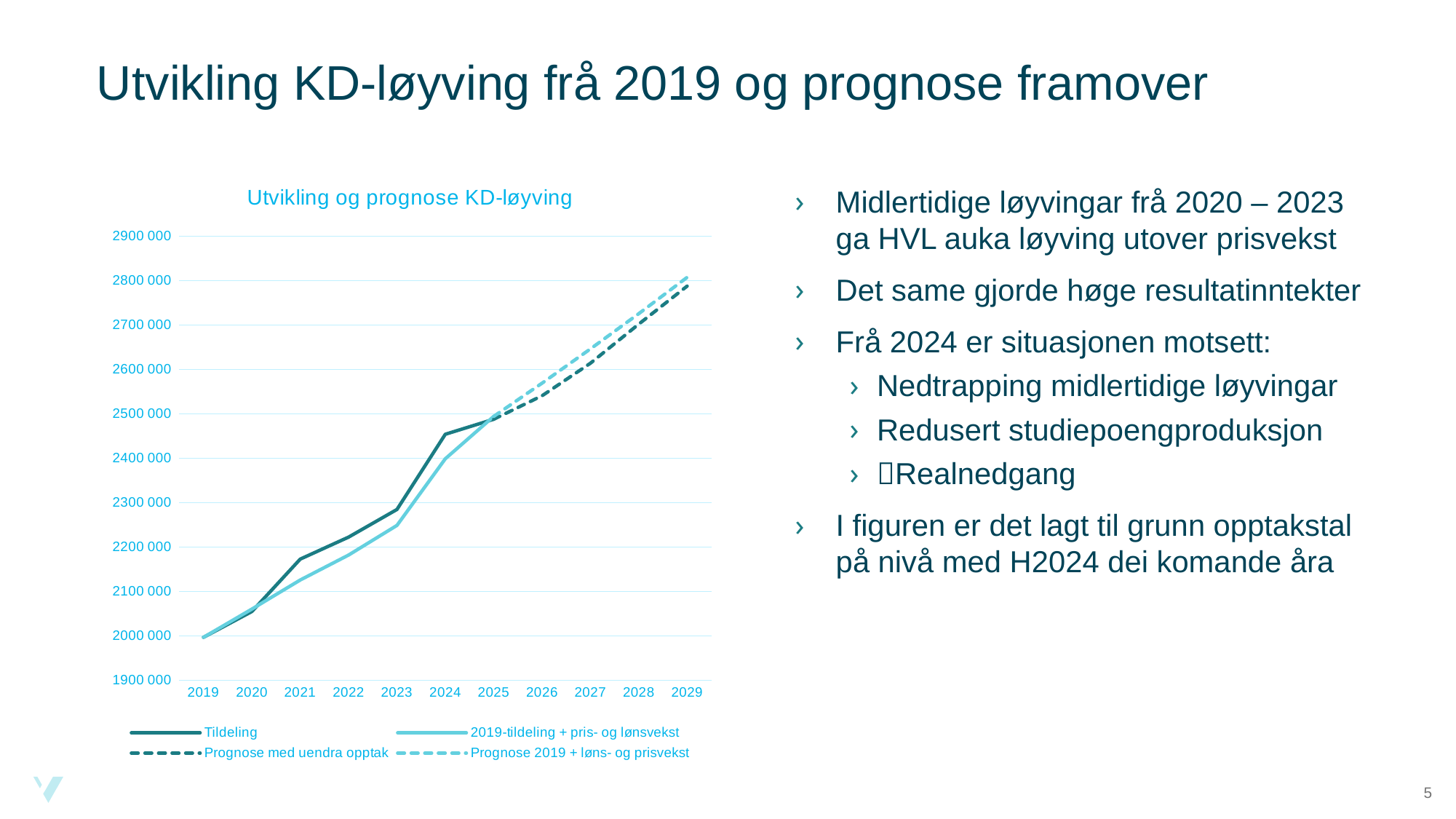
In 2024, which is larger: Tildeling or 2019-tildeling + pris- og lønsvekst? Tildeling Is the value for Prognose 2019 + løns- og prisvekst in 2027 greater or less than 2600 000? greater What is the title of the chart? Utvikling og prognose KD-løyving How many series does the chart legend list? 4 Is the value for 2019-tildeling + pris- og lønsvekst in 2023 greater or less than 2300 000? less How many years are shown on the x axis of the chart? 11 Is the value for Tildeling in 2024 greater or less than 2400 000? greater What kind of chart is shown on the slide? line chart Does the Tildeling series rise or fall from 2019 to 2025? rise Which series in the legend is drawn as a dark dashed line? Prognose med uendra opptak In which year does the Tildeling series reach its lowest value? 2019